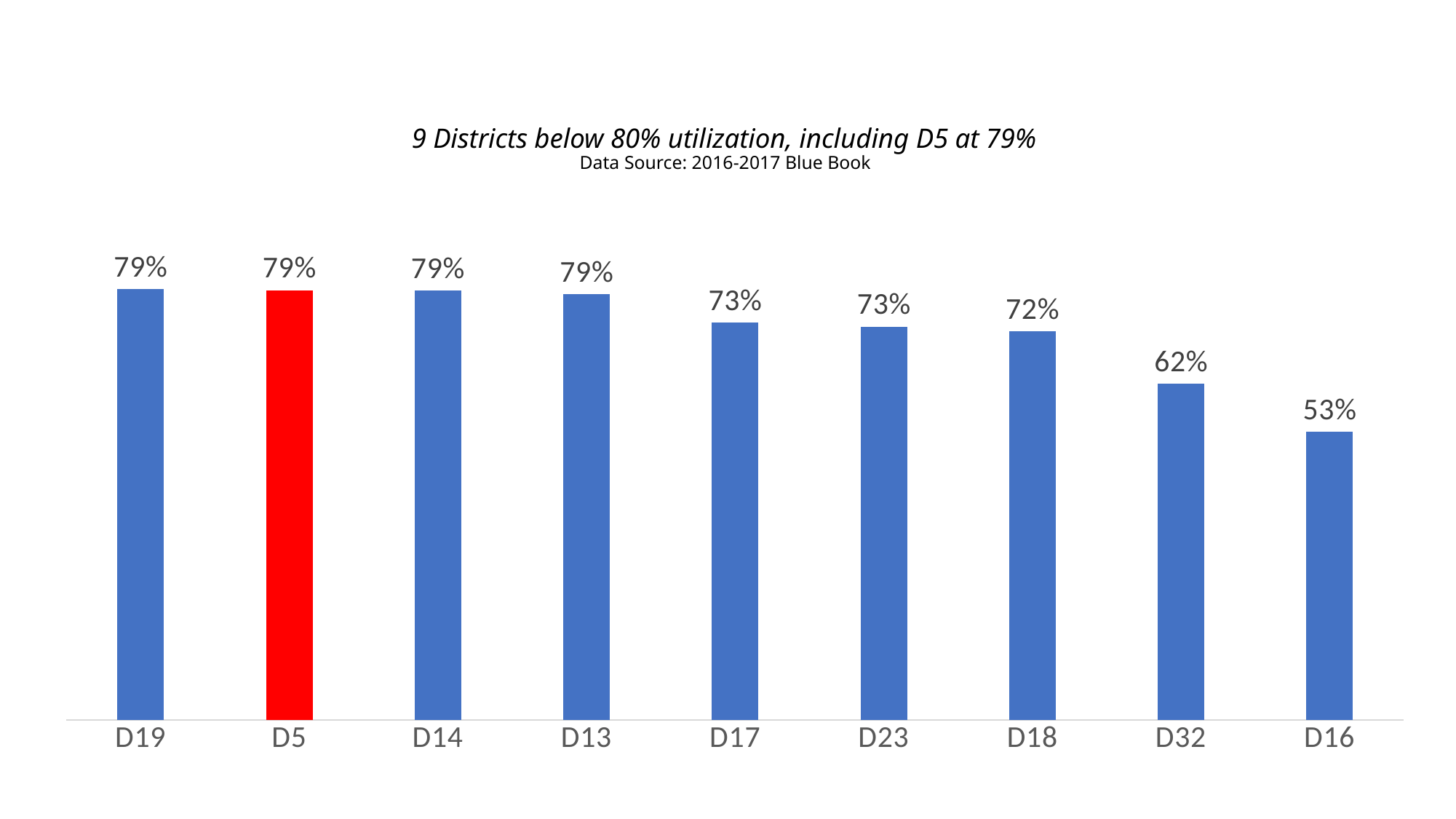
What is the utilization value for D16? 53% Which district has the lowest utilization? D16 What is the difference between the utilization of D17 and D32? 11% Which district's bar is coloured red? D5 Do the values rise or fall from left to right across the chart? Fall What kind of chart is shown on the slide? Bar chart What is the utilization value for D32? 62% What is the difference between the utilization of D19 and D16? 26% What is the utilization value for D5? 79% How many districts are shown in the chart? 9 What is the utilization value for D18? 72% Which has a higher utilization, D23 or D32? D23